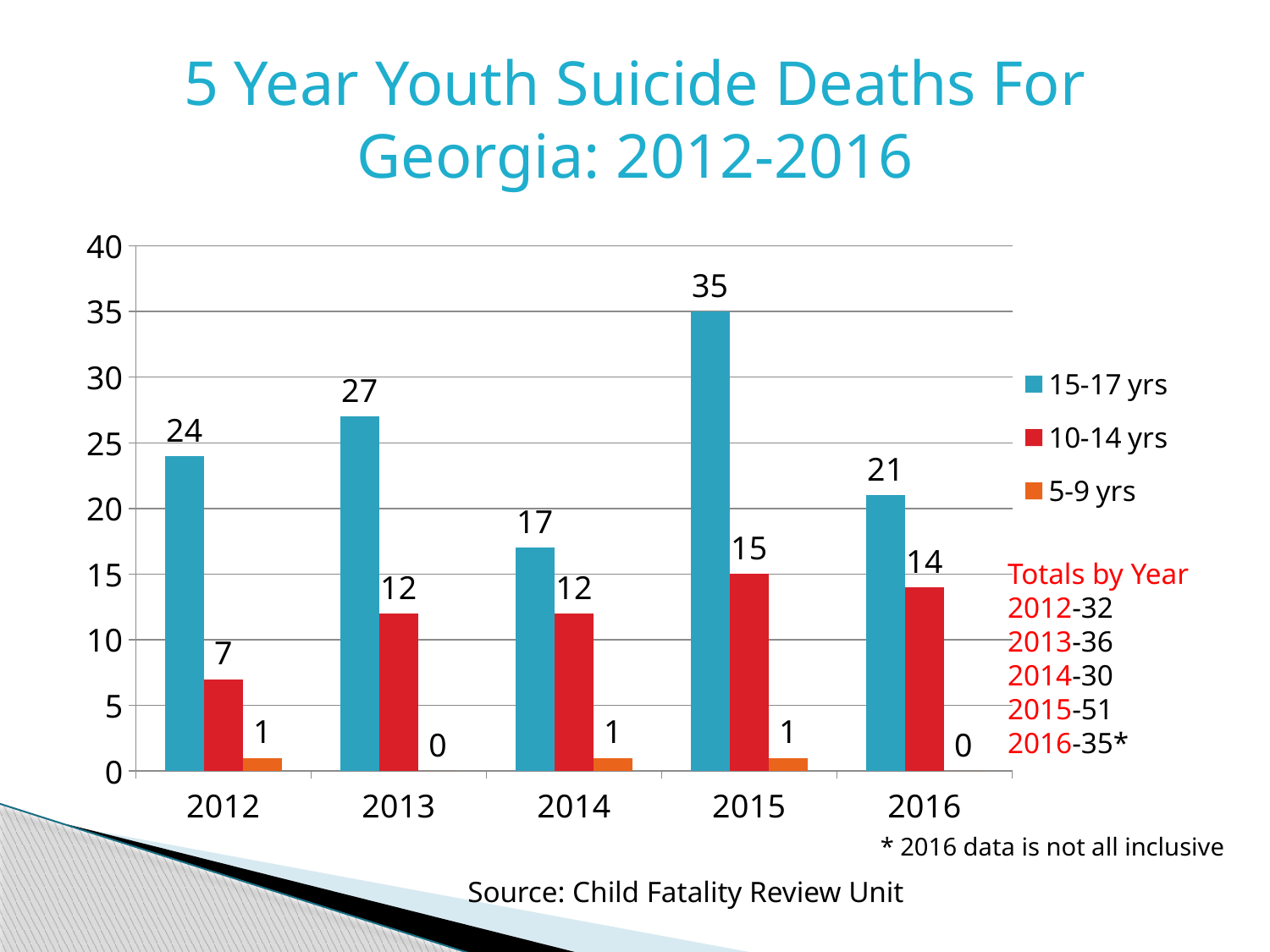
Is the value for 15-17 yrs in 2013 greater or less than 25? greater How many years are shown on the x axis? 5 What kind of chart is shown on the slide? bar chart How many series does the legend list? 3 What is the title of the chart? 5 Year Youth Suicide Deaths For Georgia: 2012-2016 Which year has the highest value for 15-17 yrs? 2015 What is the value for 5-9 yrs in 2013? 0 What is the difference between the 15-17 yrs values for 2015 and 2014? 18 What is the value for 10-14 yrs in 2012? 7 What is the value for 15-17 yrs in 2015? 35 Which year has the lowest value for 10-14 yrs? 2012 Which is larger, the 10-14 yrs value for 2015 or for 2016? 2015